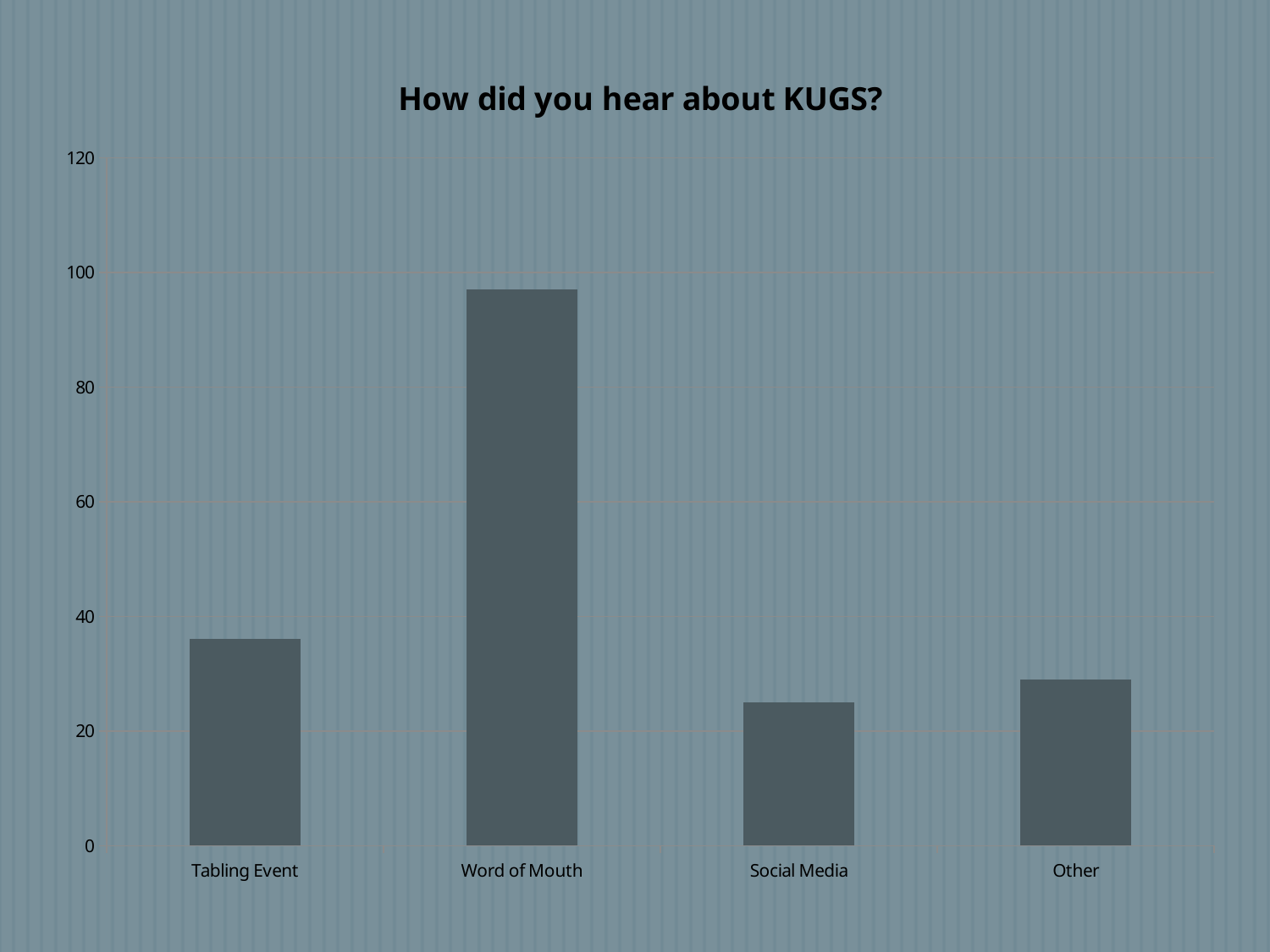
Which category has the lowest value? Social Media How many categories are shown on the x axis? 4 Which is larger, the value for Tabling Event or the value for Other? Tabling Event What is the title of the chart? How did you hear about KUGS? Is the value for Tabling Event greater or less than 40? less Is the value for Word of Mouth greater or less than 80? greater Which category has the highest value? Word of Mouth Is the value for Tabling Event greater or less than 20? greater What kind of chart is shown on the slide? bar chart